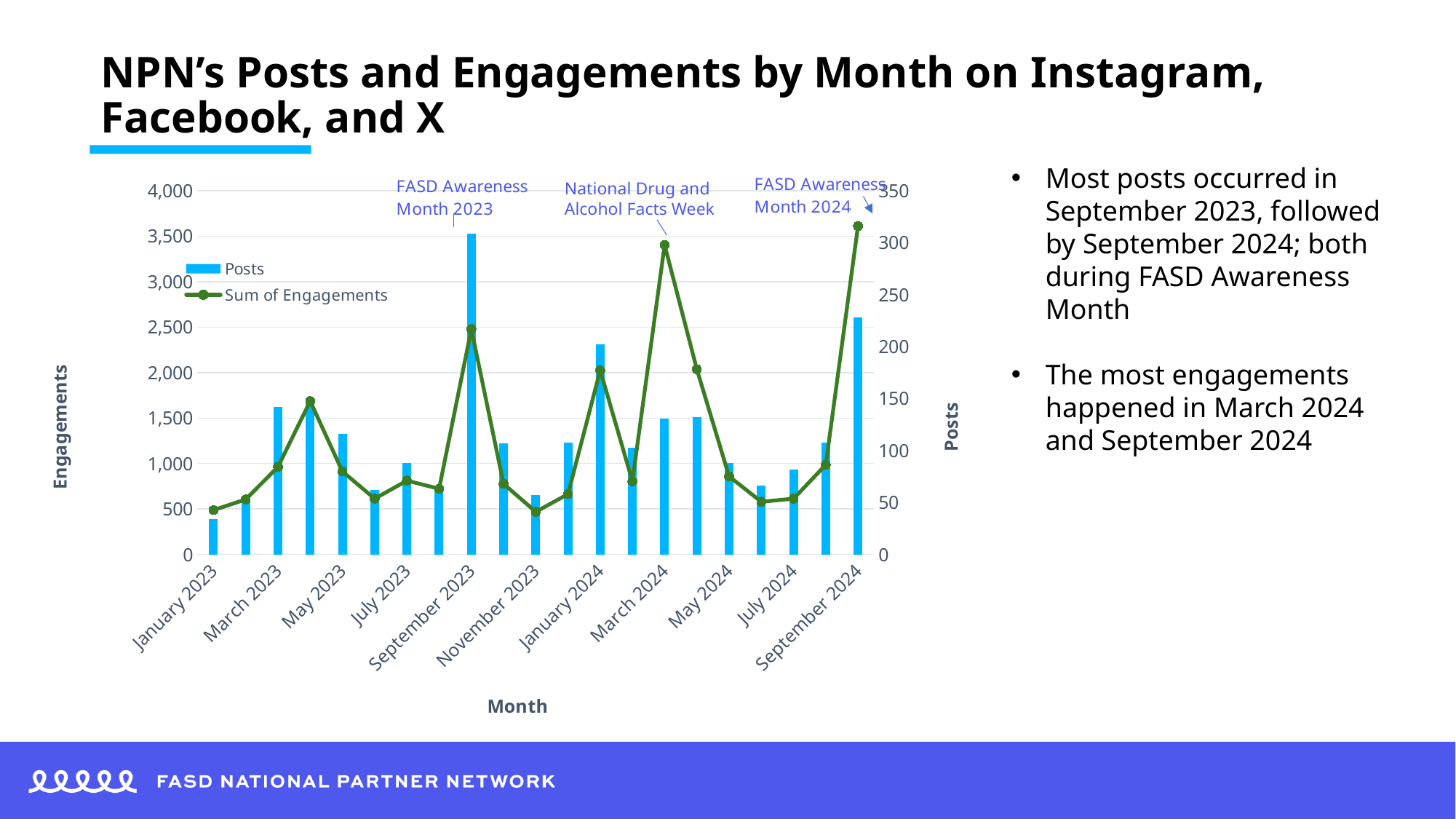
Is the sum of engagements in March 2024 greater or less than 3,000? greater Which month has a higher sum of engagements, March 2024 or September 2023? March 2024 How many series does the chart legend list? 2 Which month has the lowest number of posts? January 2023 Does the sum of engagements rise or fall from January 2023 to April 2023? rise What kind of chart is shown on the slide? A combined bar and line chart Which month has more posts, September 2023 or September 2024? September 2023 Is the sum of engagements in November 2023 greater or less than 1,000? less What are the two series named in the chart legend? Posts and Sum of Engagements Is the number of posts in September 2023 greater or less than 250? greater How many months are plotted along the x axis of the chart? 21 Which month has the highest number of posts? September 2023